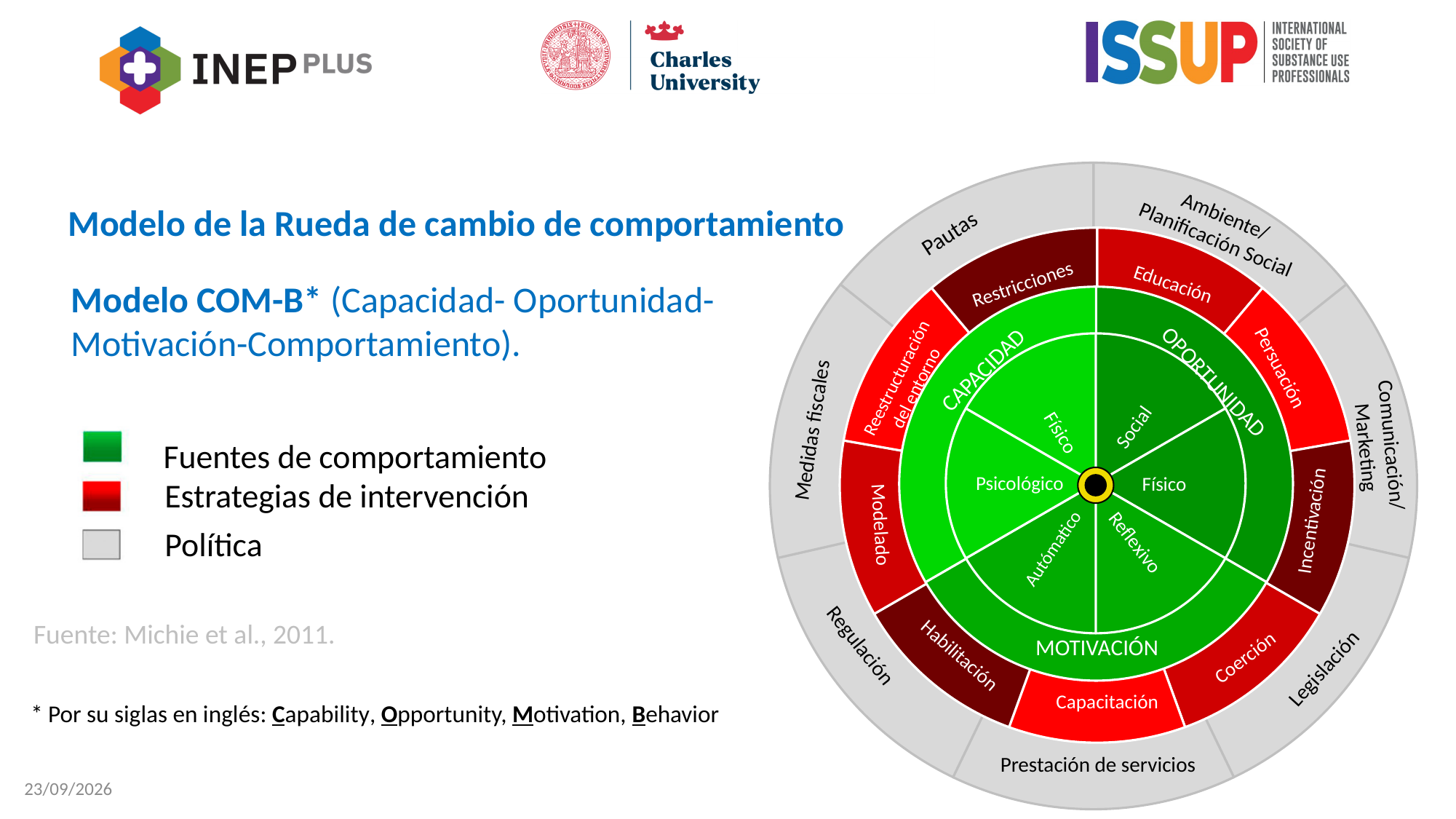
How many intervention strategy segments are in the red ring of the wheel? 9 How many entries does the legend on the left of the slide list? 3 Which policy segment is at the bottom of the outer ring of the wheel? Prestación de servicios Which intervention segment lies between 'Educación' and 'Incentivación' in the red ring? Persuación Which colour in the legend represents 'Estrategias de intervención'? Red Which two subcomponents are shown inside the 'CAPACIDAD' section of the wheel? Físico and Psicológico Which two subcomponents are shown inside the 'OPORTUNIDAD' section of the wheel? Social and Físico Which two subcomponents are shown inside the 'MOTIVACIÓN' section of the wheel? Automático and Reflexivo How many sources of behaviour are shown in the green ring of the wheel? 3 How many segments does the outer grey ring (Política) of the wheel contain? 7 Which colour in the legend represents 'Política'? Grey